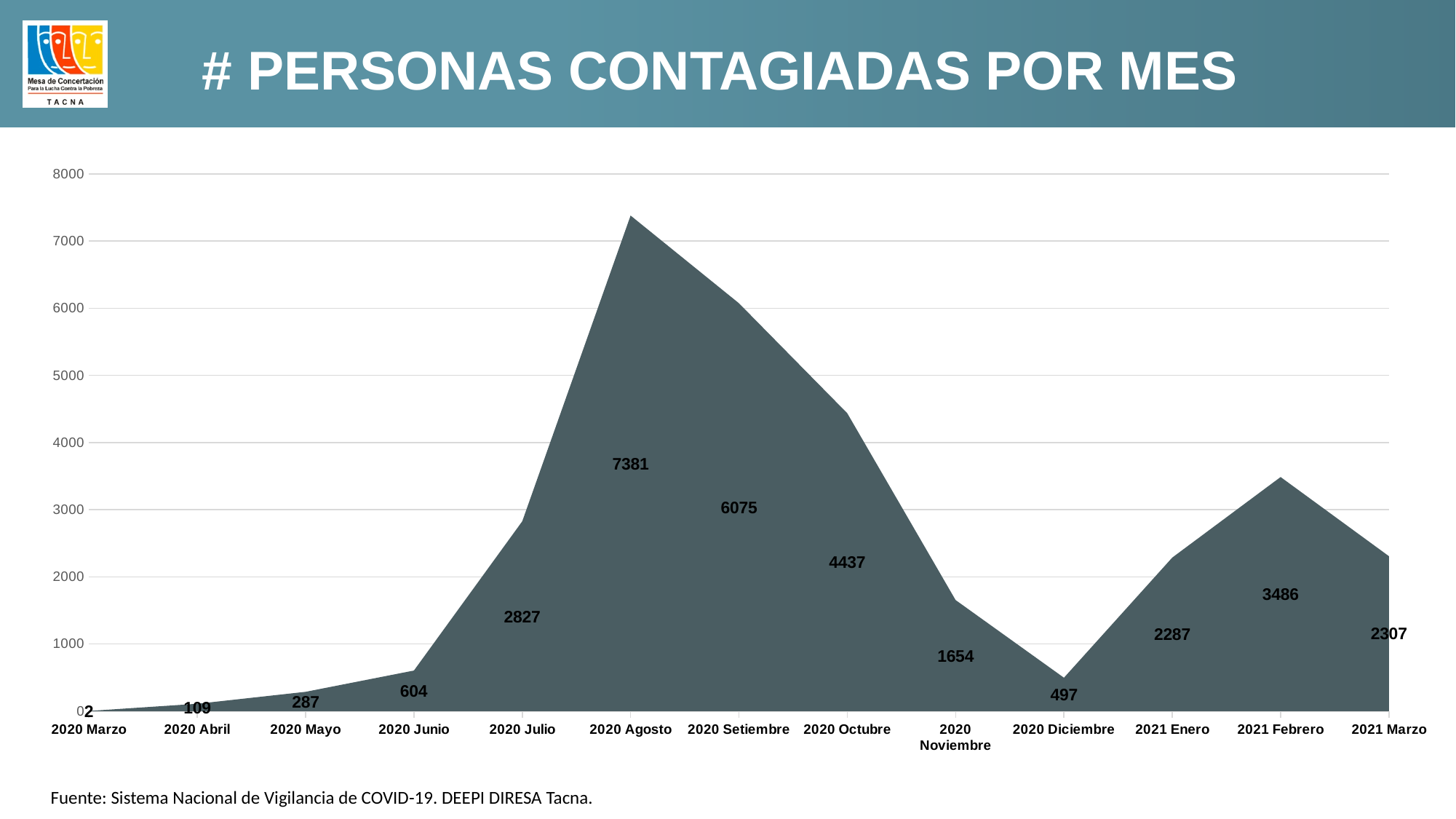
Is the value for 2020 Julio greater or less than 3000? less What is the difference between the values for 2021 Febrero and 2021 Marzo? 1179 Which month has the highest number of infected people? 2020 Agosto How many months are plotted on the chart? 13 What is the value for 2021 Febrero? 3486 Which is larger, the value for 2020 Octubre or the value for 2021 Febrero? 2020 Octubre Do the values rise or fall from 2020 Agosto to 2020 Diciembre? fall What is the value for 2020 Diciembre? 497 What is the difference between the values for 2020 Agosto and 2020 Setiembre? 1306 Which month has the lowest number of infected people? 2020 Marzo What kind of chart is shown on the slide? area chart What is the value for 2020 Agosto? 7381